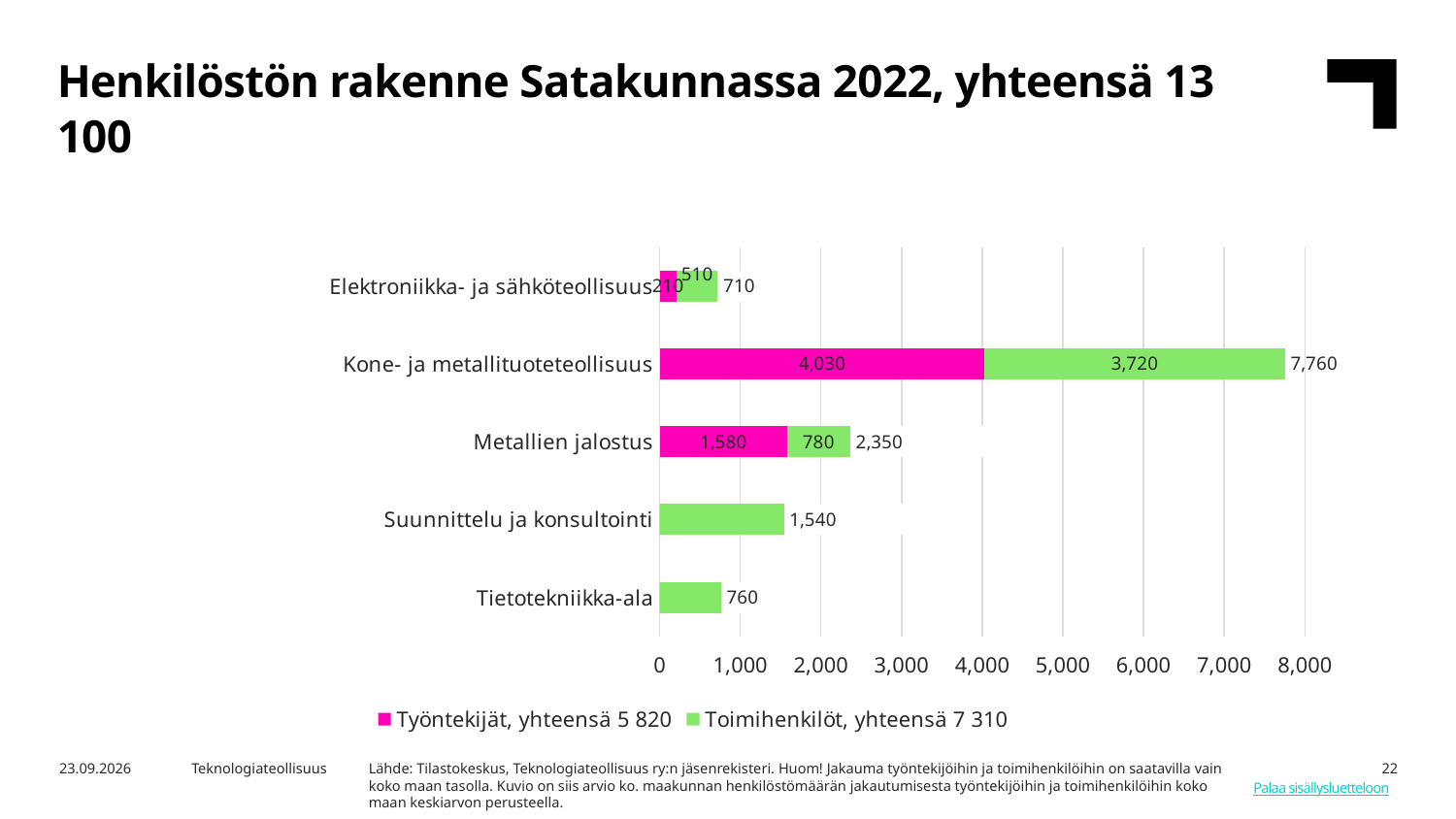
Which is larger: the value for Suunnittelu ja konsultointi or the value for Tietotekniikka-ala? Suunnittelu ja konsultointi How many categories are shown on the chart? 5 What is the Työntekijät value for Kone- ja metallituoteteollisuus? 4,030 Which category has the highest total value? Kone- ja metallituoteteollisuus Which category has the lowest total value? Elektroniikka- ja sähköteollisuus What total is given for Toimihenkilöt in the legend? 7 310 What is the total value shown for Elektroniikka- ja sähköteollisuus? 710 What is the Toimihenkilöt value for Metallien jalostus? 780 What type of chart is shown on the slide? bar chart What is the total value shown for Kone- ja metallituoteteollisuus? 7,760 What is the difference between the Työntekijät and Toimihenkilöt values for Metallien jalostus? 800 How many series does the legend list? 2